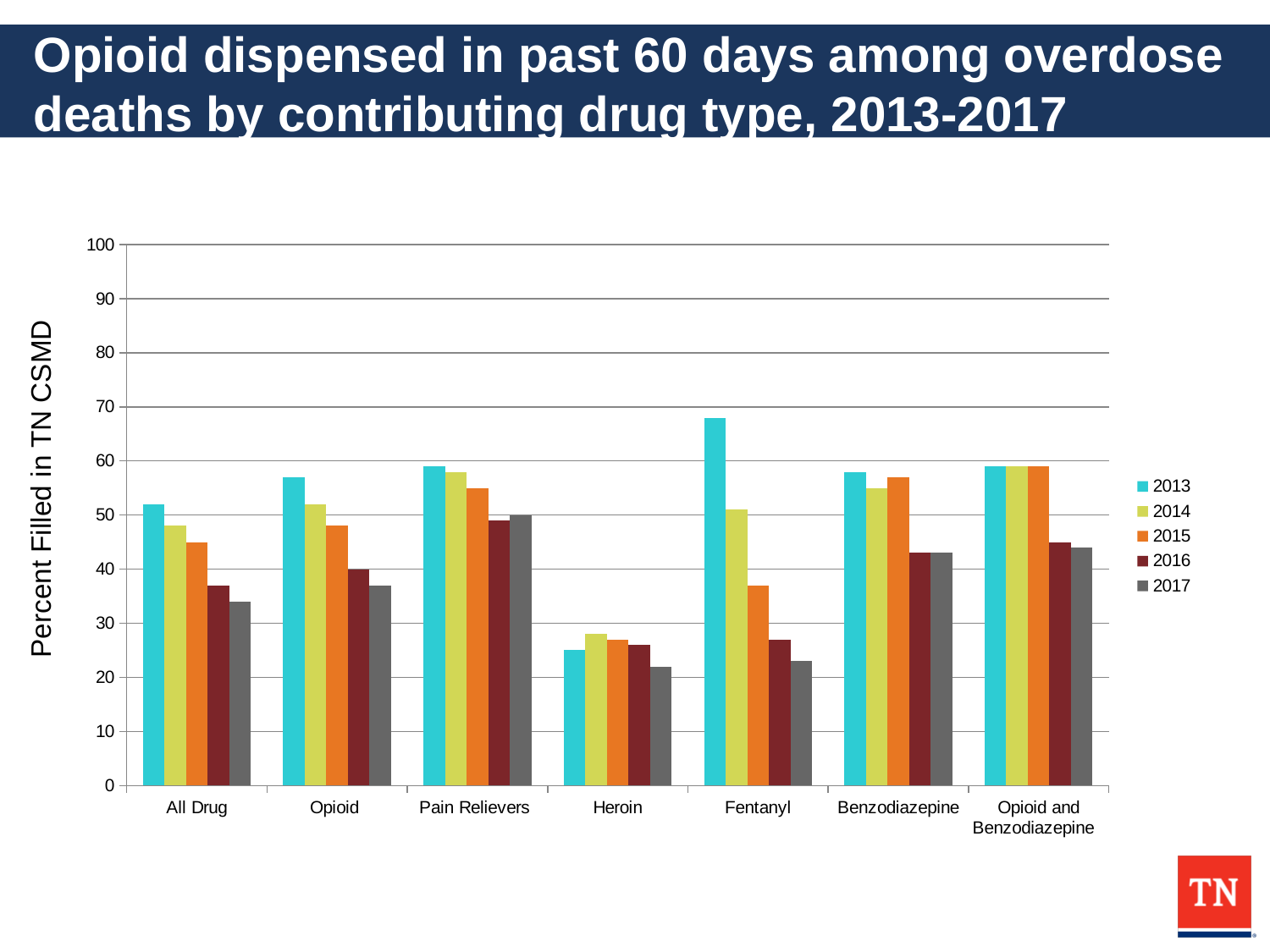
Is the 2013 value for Opioid and Benzodiazepine greater or less than 50? greater How many years does the legend list? 5 What is the label of the vertical axis? Percent Filled in TN CSMD For Fentanyl, which is larger: the 2013 value or the 2017 value? 2013 What kind of chart is shown on the slide? bar chart Is the 2013 value for Fentanyl greater or less than 60? greater Do the values for All Drug rise or fall from 2013 to 2017? fall Which drug type has the highest value for 2013? Fentanyl Is the 2017 value for Heroin greater or less than 30? less How many drug type categories are shown on the x axis? 7 Which drug type has the highest value for 2017? Pain Relievers Which drug type has the lowest value for 2014? Heroin